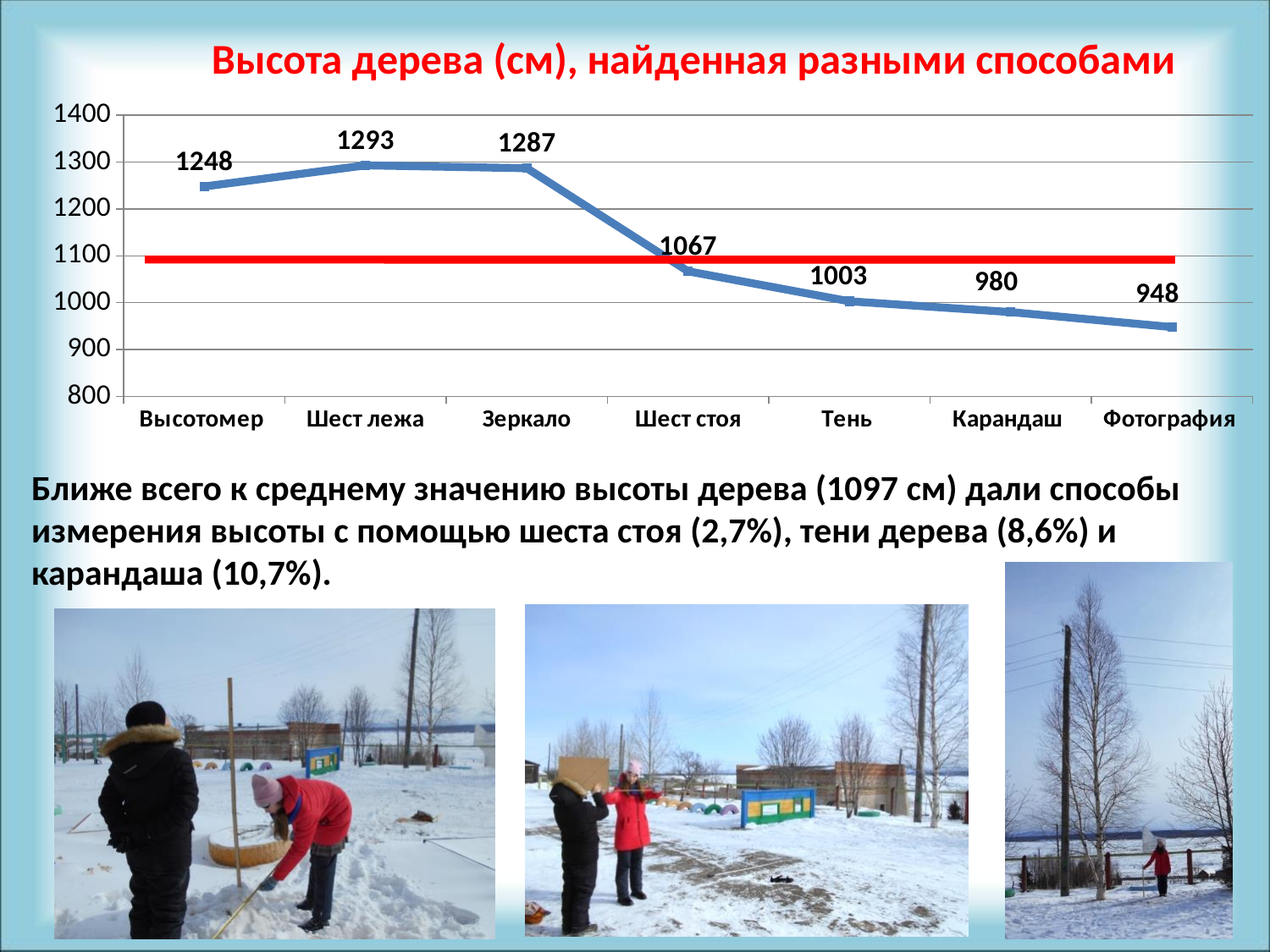
What is the tree height found by the Фотография method? 948 Which method gives the lowest tree height? Фотография What is the difference between the heights found by Шест стоя and Карандаш? 87 What is the tree height found by the Тень method? 1003 What kind of chart is shown on the slide? line chart What is the title of the chart? Высота дерева (см), найденная разными способами Which is larger, the height found by Зеркало or by Тень? Зеркало What is the difference between the heights found by Шест лежа and Фотография? 345 How many measurement methods are shown on the x axis? 7 Which method gives the highest tree height? Шест лежа Is the value for Карандаш greater or less than 1100? less What is the tree height found by the Высотомер method? 1248